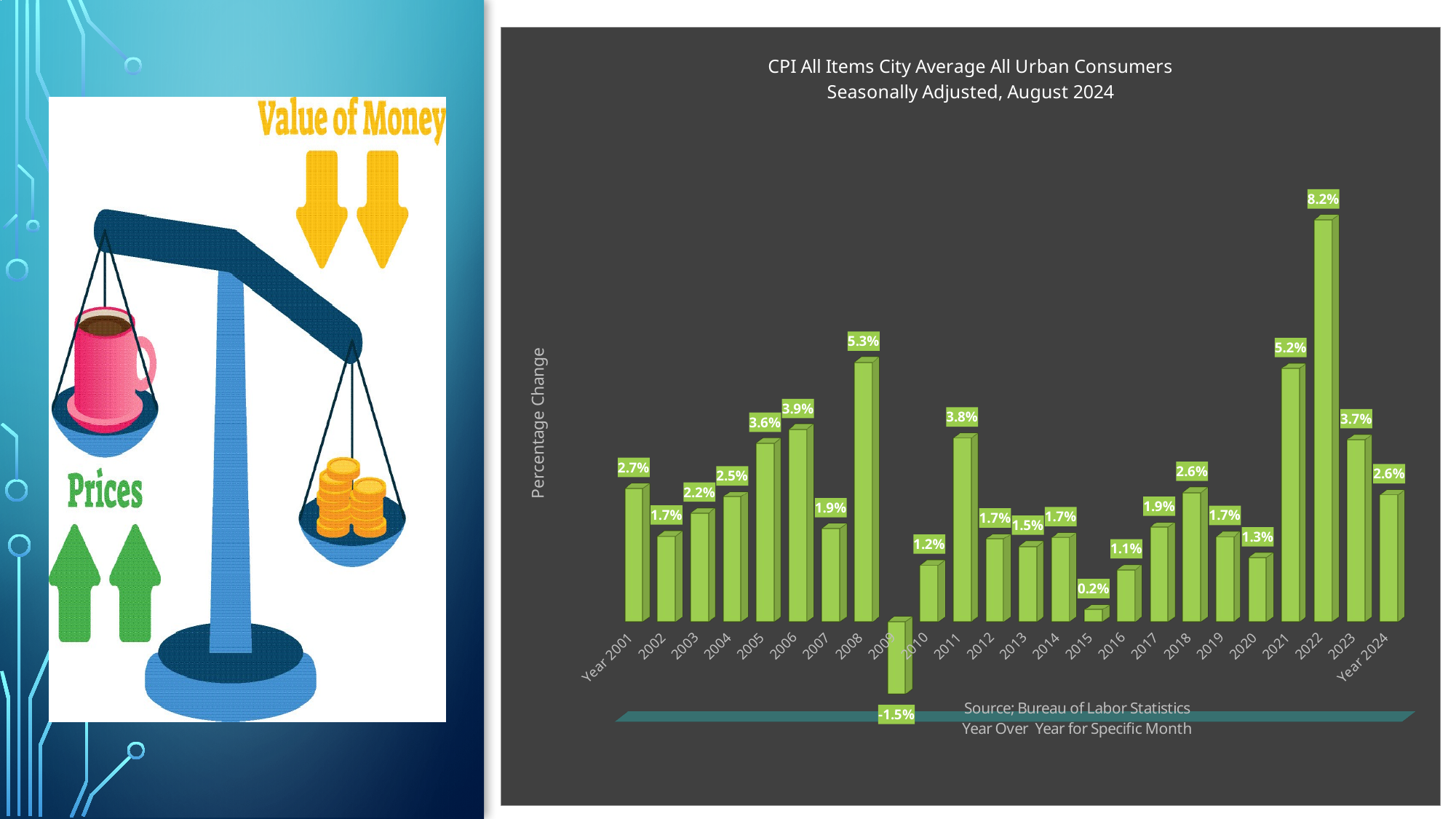
Which year has the highest value? 2022 How many years are shown in the chart? 24 What is the difference between the values for 2023 and Year 2024? 1.1% What kind of chart is this? Bar chart Which is larger, the value for 2011 or the value for 2006? 2006 What is the difference between the values for 2022 and 2021? 3.0% Which year has the lowest value? 2009 What is the value for Year 2024? 2.6% What is the value for 2009? -1.5% What is the label on the vertical axis? Percentage Change What is the value for 2008? 5.3% What is the value for 2022? 8.2%